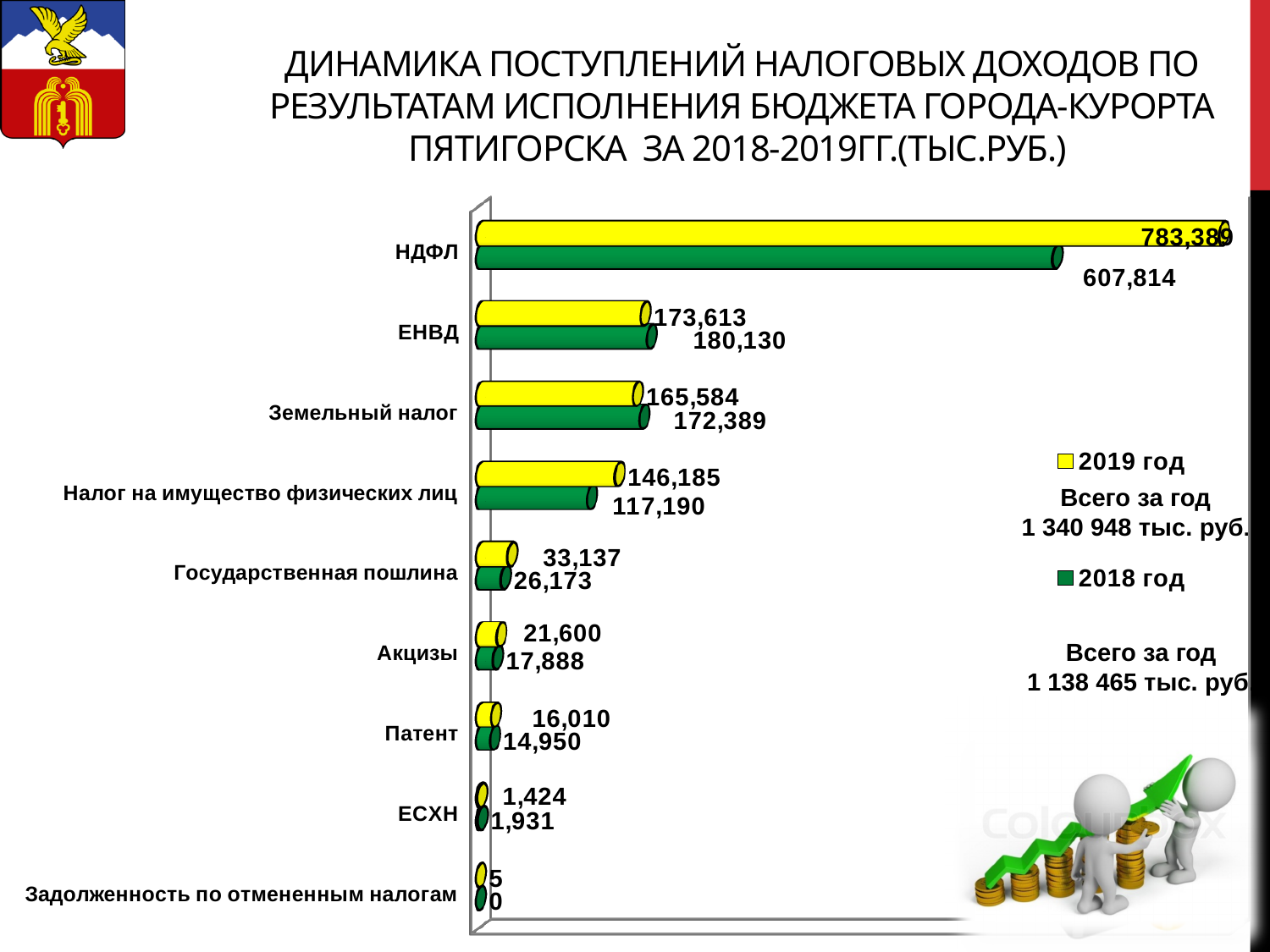
What is the 2019 год value for ЕНВД? 173,613 What is the 2018 год value for Патент? 14,950 What type of chart is shown on the slide? bar chart What is the difference between the 2019 год and 2018 год values for Налог на имущество физических лиц? 28,995 Which category has the lowest value for 2018 год? Задолженность по отмененным налогам What is the 2018 год value for НДФЛ? 607,814 How many tax categories are shown on the chart? 9 What is the 2019 год value for Налог на имущество физических лиц? 146,185 How many series does the legend list? 2 Which category has the highest value for 2019 год? НДФЛ For ЕСХН, which is larger: the 2019 год value or the 2018 год value? 2018 год What is the 2018 год value for Земельный налог? 172,389